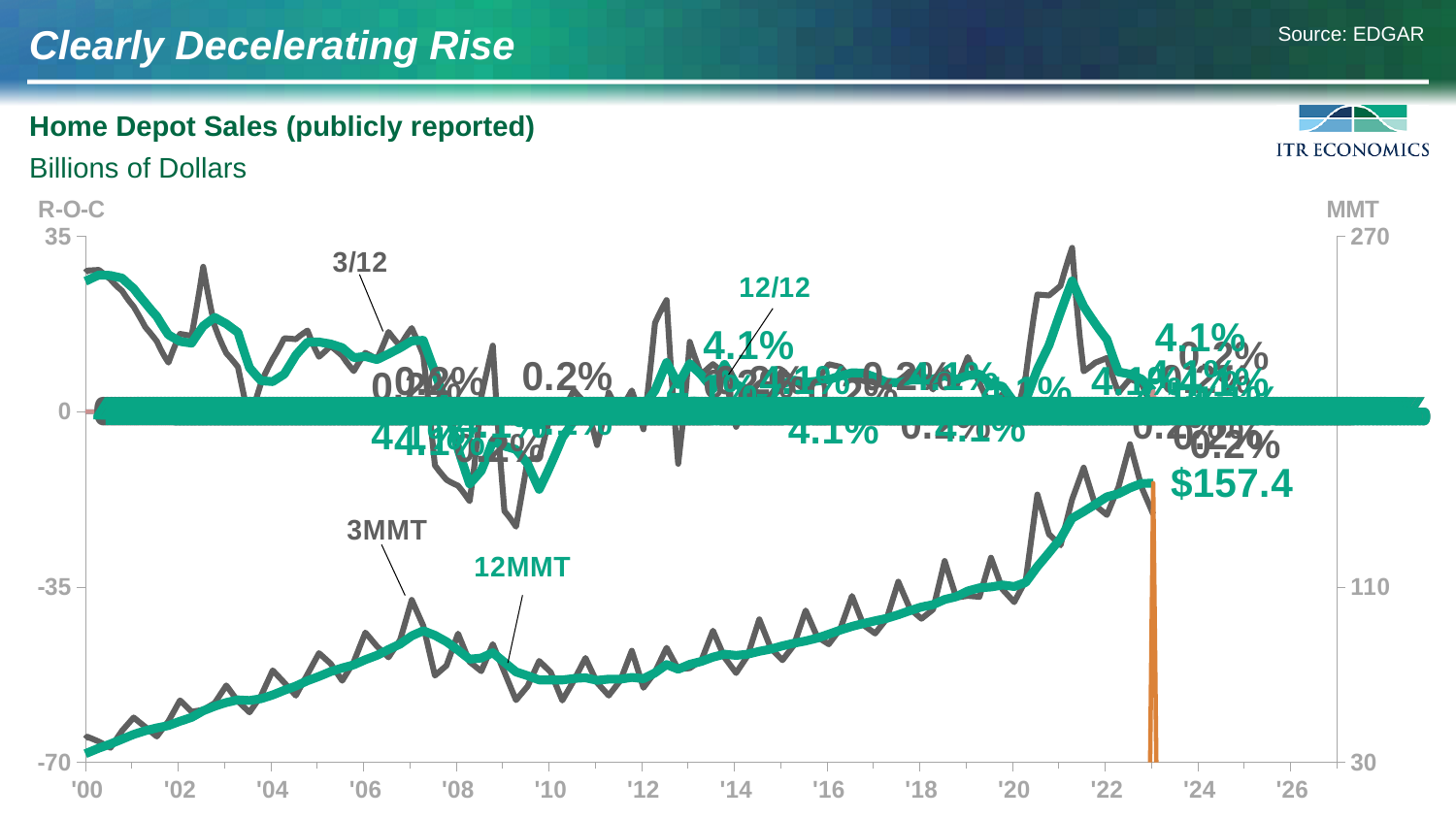
What is the latest value labeled on the 12MMT line? $157.4 Is the 12MMT value around '10 greater or less than 110 on the MMT axis? less Is the 12MMT value around '22 greater or less than 110 on the MMT axis? greater How many labeled data series are plotted on the chart? 4 Is the 3/12 value around '09 greater or less than 0 on the R-O-C axis? less Does the 12MMT line generally rise or fall from '00 to '22? Rise What is the highest tick value shown on the right-hand MMT axis? 270 In what units are the values on the chart expressed? Billions of Dollars What is the title of the chart? Home Depot Sales (publicly reported) What is the lowest tick value shown on the left-hand R-O-C axis? -70 What kind of chart is shown on the slide? Line chart